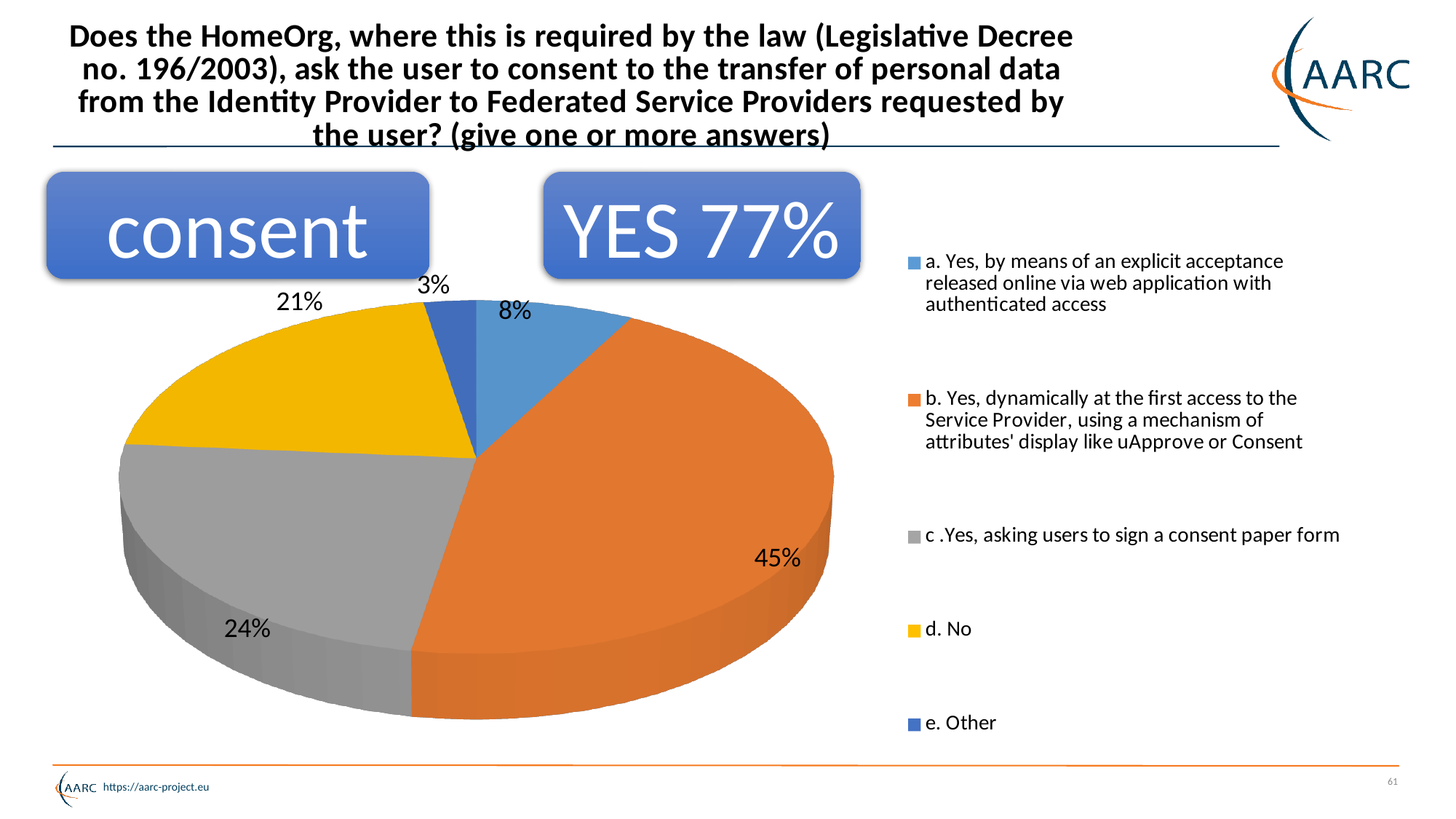
What percentage of the pie is the slice for 'c. Yes, asking users to sign a consent paper form'? 24% Which answer option has the smallest share of the pie? e. Other Which slice is larger: 'c. Yes, asking users to sign a consent paper form' or 'd. No'? c. Yes, asking users to sign a consent paper form What percentage of the pie is the slice for 'b. Yes, dynamically at the first access to the Service Provider, using a mechanism of attributes' display like uApprove or Consent'? 45% Which answer option has the largest share of the pie? b. Yes, dynamically at the first access to the Service Provider, using a mechanism of attributes' display like uApprove or Consent What is the difference in percentage points between the 'd. No' slice and the 'e. Other' slice? 18 How many slices does the pie chart have? 5 What percentage of the pie is the slice for 'd. No'? 21% What colour is the slice for 'd. No' in the pie chart? yellow What percentage of the pie is the slice for 'e. Other'? 3% What kind of chart is shown on the slide? pie chart What percentage of the pie is the slice for 'a. Yes, by means of an explicit acceptance released online via web application with authenticated access'? 8%